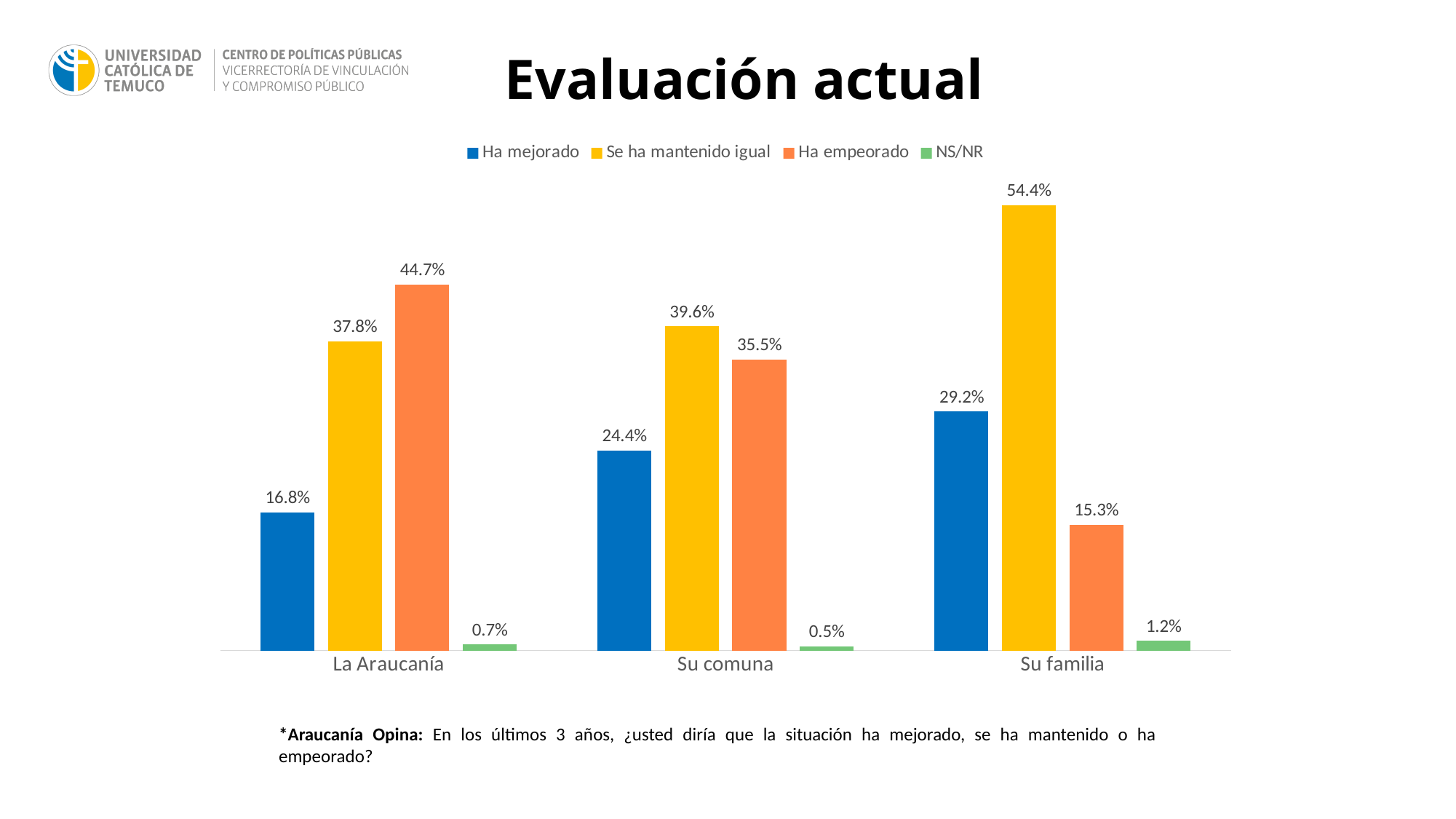
What kind of chart is shown on the slide? Bar chart Which is larger in the La Araucanía category: "Se ha mantenido igual" or "Ha empeorado"? Ha empeorado How many series does the legend list? 4 Which category has the highest value for "Ha mejorado"? Su familia Which category has the lowest value for "Ha empeorado"? Su familia Which series is shown in yellow in the legend? Se ha mantenido igual What is the value for "NS/NR" in the Su familia category? 1.2% What is the value for "Ha empeorado" in the La Araucanía category? 44.7% How many categories are shown on the x axis? 3 What is the value for "Se ha mantenido igual" in the Su familia category? 54.4% What is the difference between "Se ha mantenido igual" and "Ha mejorado" in the Su familia category? 25.2% What is the value for "Ha mejorado" in the Su comuna category? 24.4%